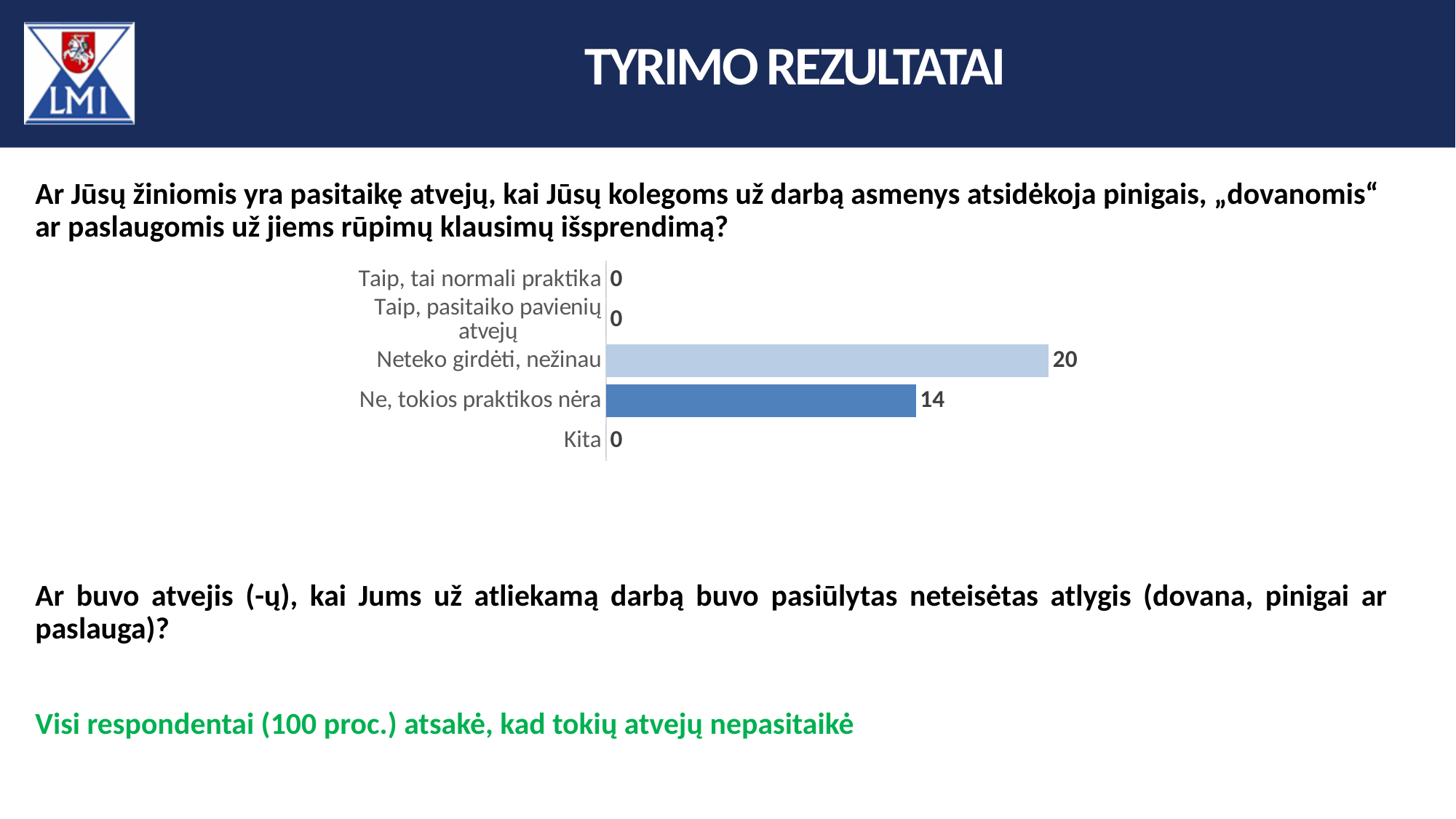
What is the value for "Ne, tokios praktikos nėra"? 14 How many categories in the chart have a value of 0? 3 What is the total of all the values shown in the chart? 34 What is the value for "Taip, pasitaiko pavienių atvejų"? 0 Which is larger: the value for "Neteko girdėti, nežinau" or the value for "Ne, tokios praktikos nėra"? Neteko girdėti, nežinau What is the difference between the values for "Neteko girdėti, nežinau" and "Ne, tokios praktikos nėra"? 6 Which category has the highest value? Neteko girdėti, nežinau What kind of chart is shown on the slide? Bar chart What is the value for "Neteko girdėti, nežinau"? 20 What is the value for "Kita"? 0 What is the value for "Taip, tai normali praktika"? 0 How many categories are shown in the chart? 5